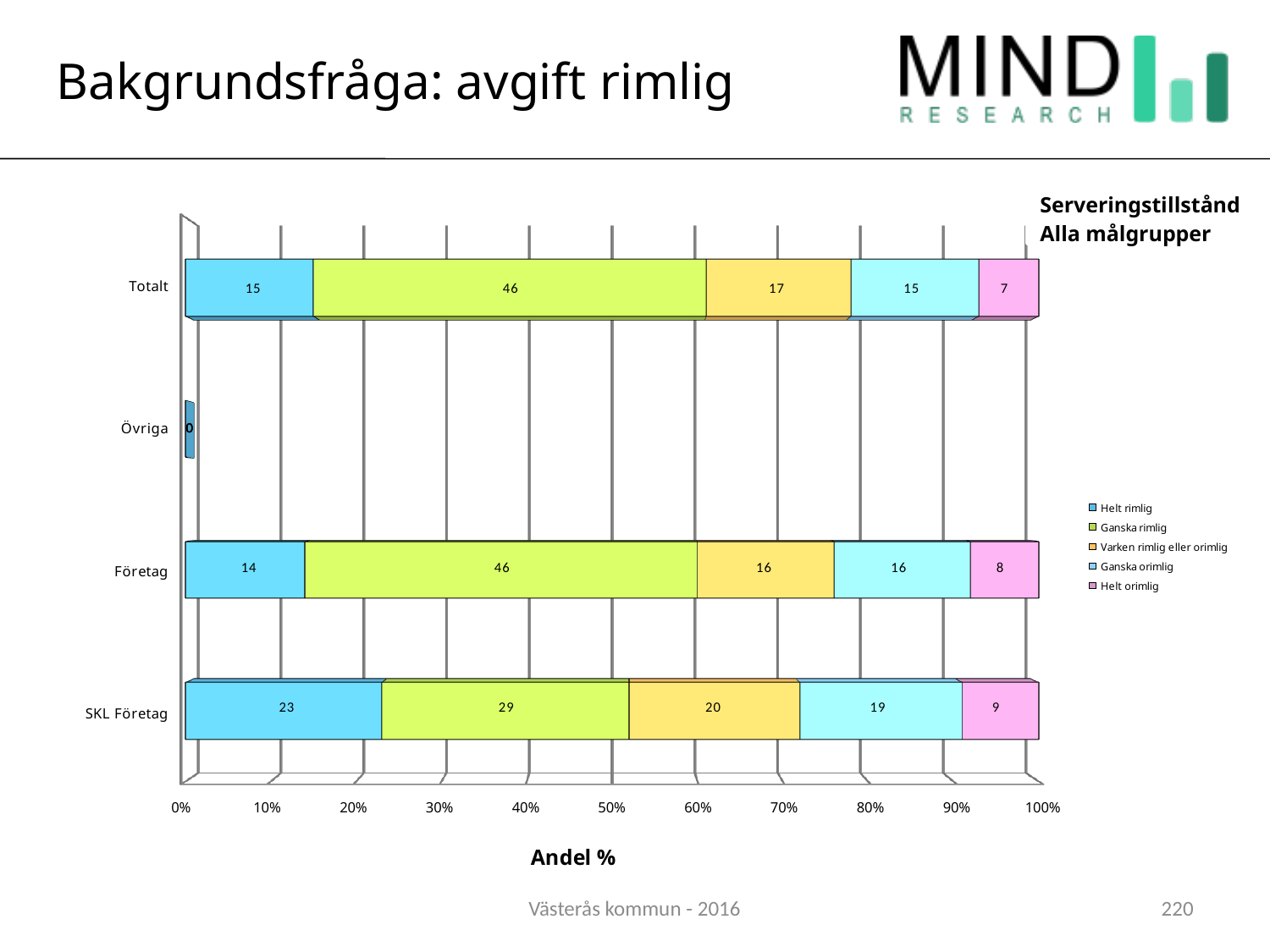
How many categories are shown on the vertical axis? 4 Which is larger: Ganska orimlig for SKL Företag or Ganska orimlig for Totalt? SKL Företag Which category has the lowest value for Ganska rimlig among Totalt, Företag and SKL Företag? SKL Företag What is the value of Helt rimlig for SKL Företag? 23 What is the value of Helt orimlig for Företag? 8 How many series does the legend list? 5 Which category has the highest value for Helt rimlig? SKL Företag What is the value of Ganska rimlig for Totalt? 46 What kind of chart is shown on the slide? Stacked bar chart What is the value of Varken rimlig eller orimlig for SKL Företag? 20 What is the difference between the Ganska rimlig values for Företag and SKL Företag? 17 What is the total of the stacked bar for Företag? 100